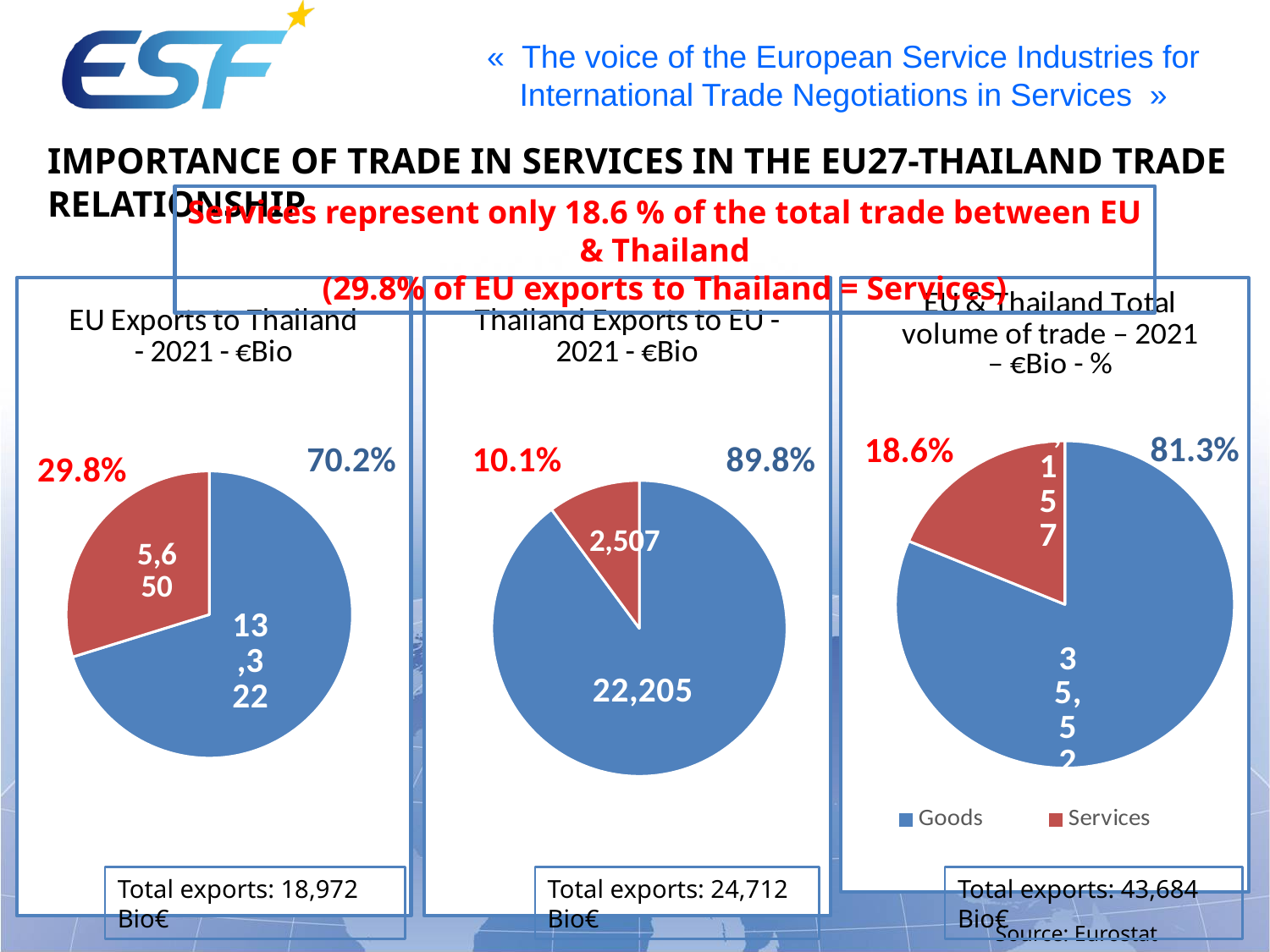
In the 'Thailand Exports to EU - 2021 - €Bio' chart, what share of the pie is Goods? 89.8% In the 'EU & Thailand Total volume of trade – 2021' chart, which slice is larger, Goods or Services? Goods In the 'Thailand Exports to EU - 2021 - €Bio' chart, what is the value for Services? 2,507 In the 'EU Exports to Thailand - 2021 - €Bio' chart, what is the value for Services? 5,650 In the 'EU & Thailand Total volume of trade – 2021' chart, what share of the pie is Services? 18.6% How many slices does the 'Thailand Exports to EU - 2021 - €Bio' pie chart have? 2 What kind of chart is used in the 'EU Exports to Thailand - 2021 - €Bio' chart? Pie chart In the 'EU Exports to Thailand - 2021 - €Bio' chart, what is the value for Goods? 13,322 In the 'EU Exports to Thailand - 2021 - €Bio' chart, what share of the pie is Services? 29.8% How many series does the legend list for the pie charts? 2 In the 'Thailand Exports to EU - 2021 - €Bio' chart, what is the difference between the Goods value and the Services value? 19,698 According to the legend, what colour represents Services in the pie charts? Red